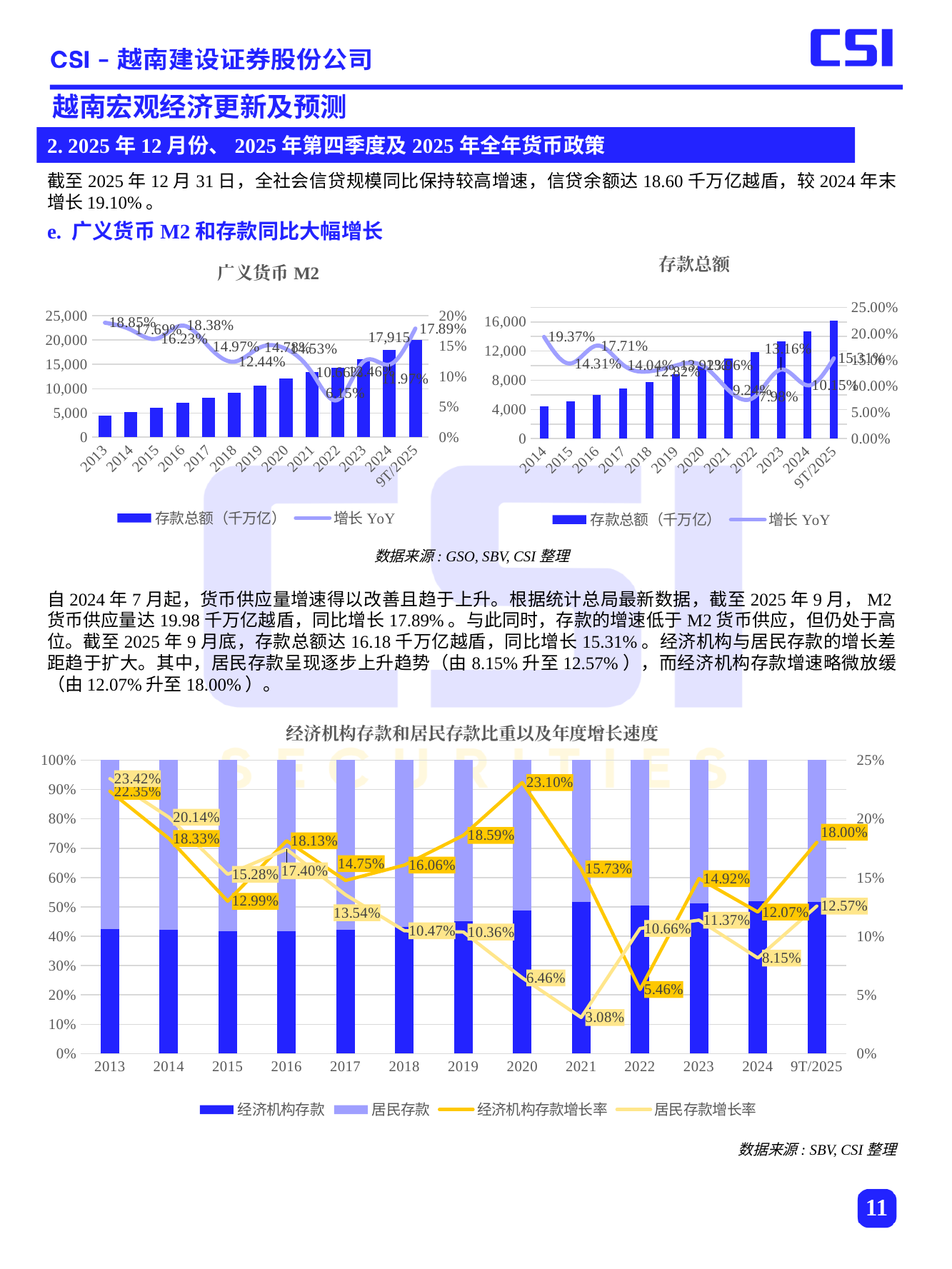
In the 存款总额 chart, what is the 增长 YoY value for 2014? 19.37% In the 广义货币 M2 chart, what is the 增长 YoY value for 2013? 18.85% In the 广义货币 M2 chart, what is the difference between the 增长 YoY values for 2013 and 2022? 12.70% In the 经济机构存款和居民存款比重以及年度增长速度 chart, what is the 居民存款增长率 for 2021? 3.08% In the 广义货币 M2 chart, what is the 增长 YoY value for 2022? 6.15% In the 存款总额 chart, what is the 增长 YoY value for 9T/2025? 15.31% In the 广义货币 M2 chart, which year has the lowest 增长 YoY value? 2022 In the 存款总额 chart, is the 存款总额 bar for 9T/2025 greater or less than 12,000? greater How many series does the legend of the 经济机构存款和居民存款比重以及年度增长速度 chart list? 4 In the 经济机构存款和居民存款比重以及年度增长速度 chart, which is larger in 2020: the 经济机构存款增长率 or the 居民存款增长率? 经济机构存款增长率 In the 广义货币 M2 chart, what is the 增长 YoY value for 9T/2025? 17.89% In the 经济机构存款和居民存款比重以及年度增长速度 chart, what is the 经济机构存款增长率 for 9T/2025? 18.00%